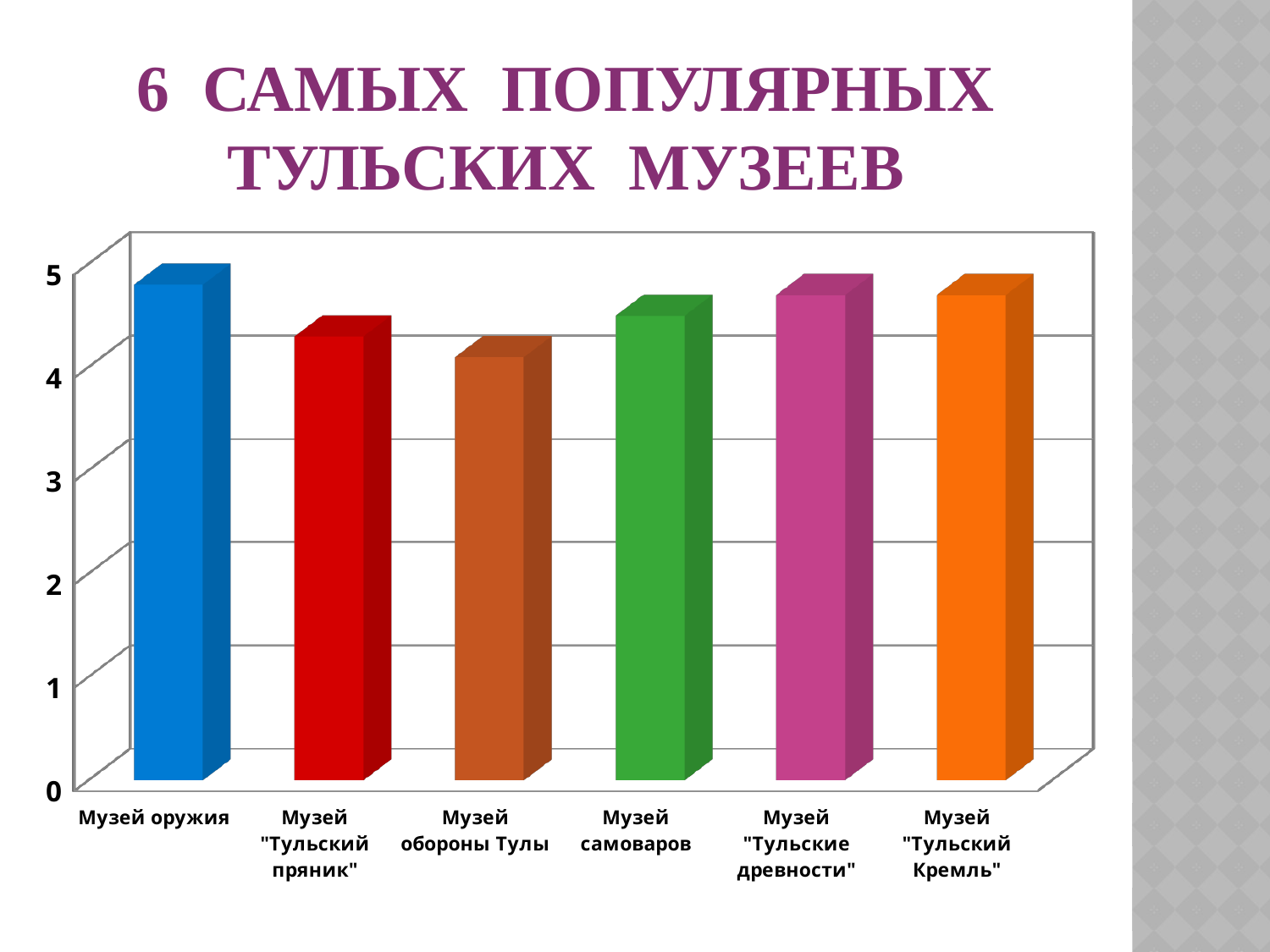
Is the value for Музей "Тульский Кремль" greater or less than 4? greater Which is larger, the value for Музей оружия or the value for Музей обороны Тулы? Музей оружия What kind of chart is shown on the slide? bar chart Is the value for Музей оружия greater or less than 4? greater What colour is the bar for Музей оружия? blue What is the title of the slide above the chart? 6 САМЫХ ПОПУЛЯРНЫХ ТУЛЬСКИХ МУЗЕЕВ Which is larger, the value for Музей самоваров or the value for Музей обороны Тулы? Музей самоваров How many museums (categories) are shown in the chart? 6 Is the value for Музей обороны Тулы greater or less than 5? less Which museum has the lowest bar in the chart? Музей обороны Тулы